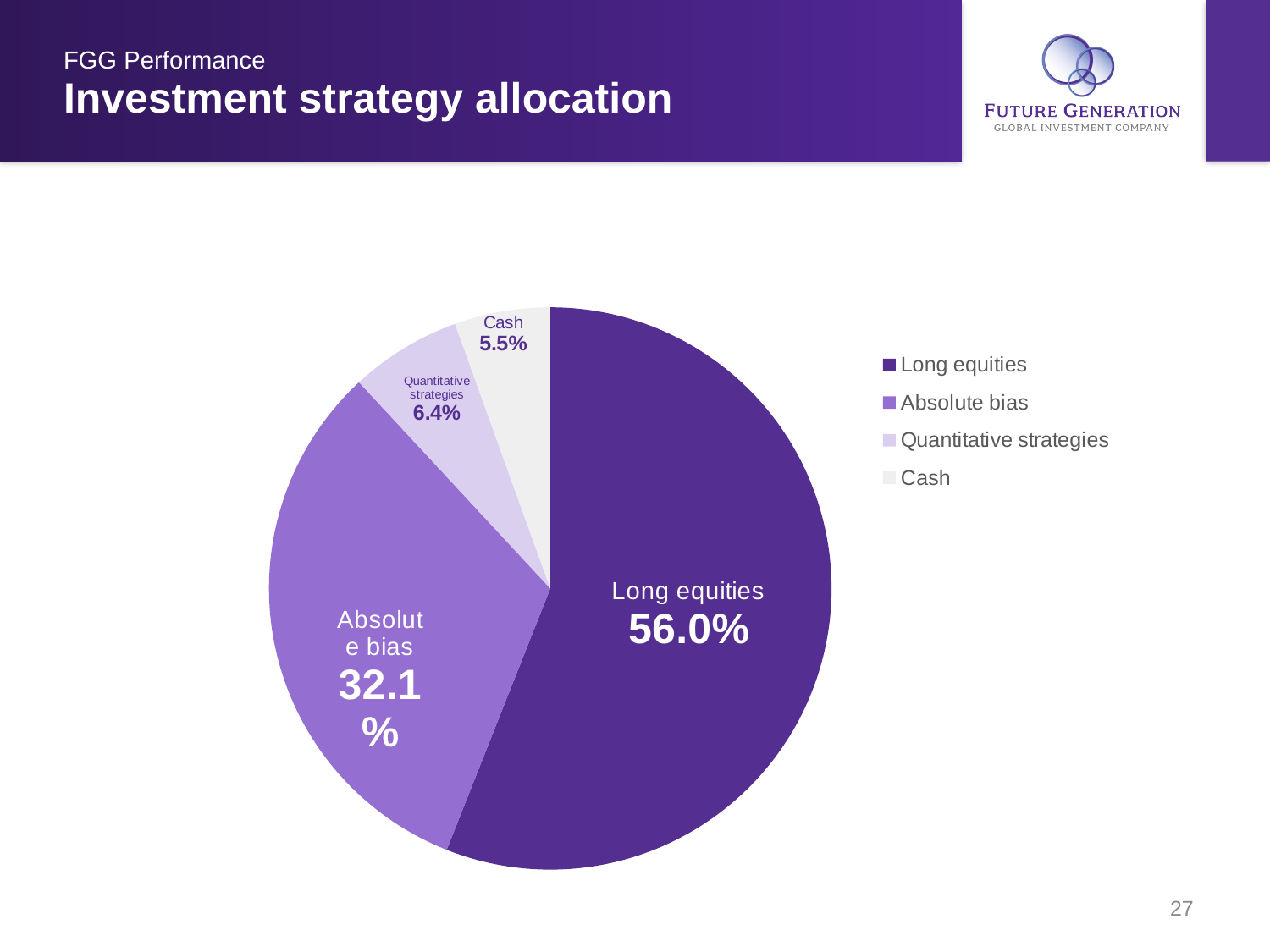
Which legend entry is listed first? Long equities How many categories does the pie chart show? 4 Which category has the smallest slice of the pie? Cash What kind of chart is shown on the slide? pie chart What share of the pie does Long equities hold? 56.0% Which is larger, the share for Absolute bias or the share for Quantitative strategies? Absolute bias What is the value shown for Quantitative strategies? 6.4% What is the difference between the Long equities and Absolute bias shares? 23.9% What is the value shown for Absolute bias? 32.1% What is the difference between the Quantitative strategies and Cash shares? 0.9% Which category has the largest slice of the pie? Long equities What is the value shown for Cash? 5.5%